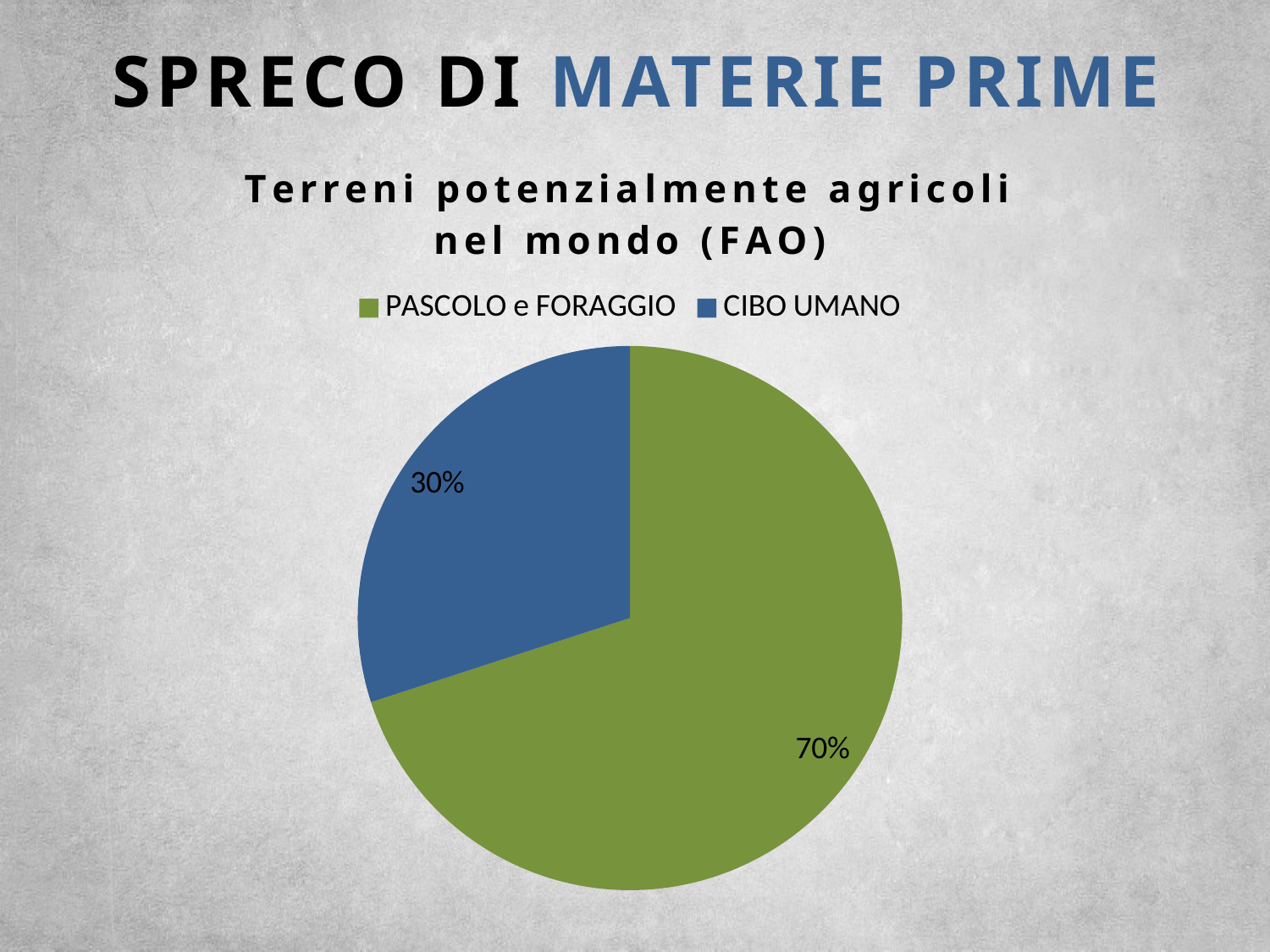
What share of the pie does CIBO UMANO represent? 30% What share of the pie does PASCOLO e FORAGGIO represent? 70% What is the title of the chart? Terreni potenzialmente agricoli nel mondo (FAO) What colour is the slice for CIBO UMANO? Blue Which category has the largest slice of the pie? PASCOLO e FORAGGIO Which category has the smallest slice of the pie? CIBO UMANO What is the difference in percentage points between PASCOLO e FORAGGIO and CIBO UMANO? 40 Which is larger, the slice for CIBO UMANO or the slice for PASCOLO e FORAGGIO? PASCOLO e FORAGGIO How many slices does the pie chart have? 2 How many entries does the legend list? 2 What kind of chart is shown on the slide? Pie chart